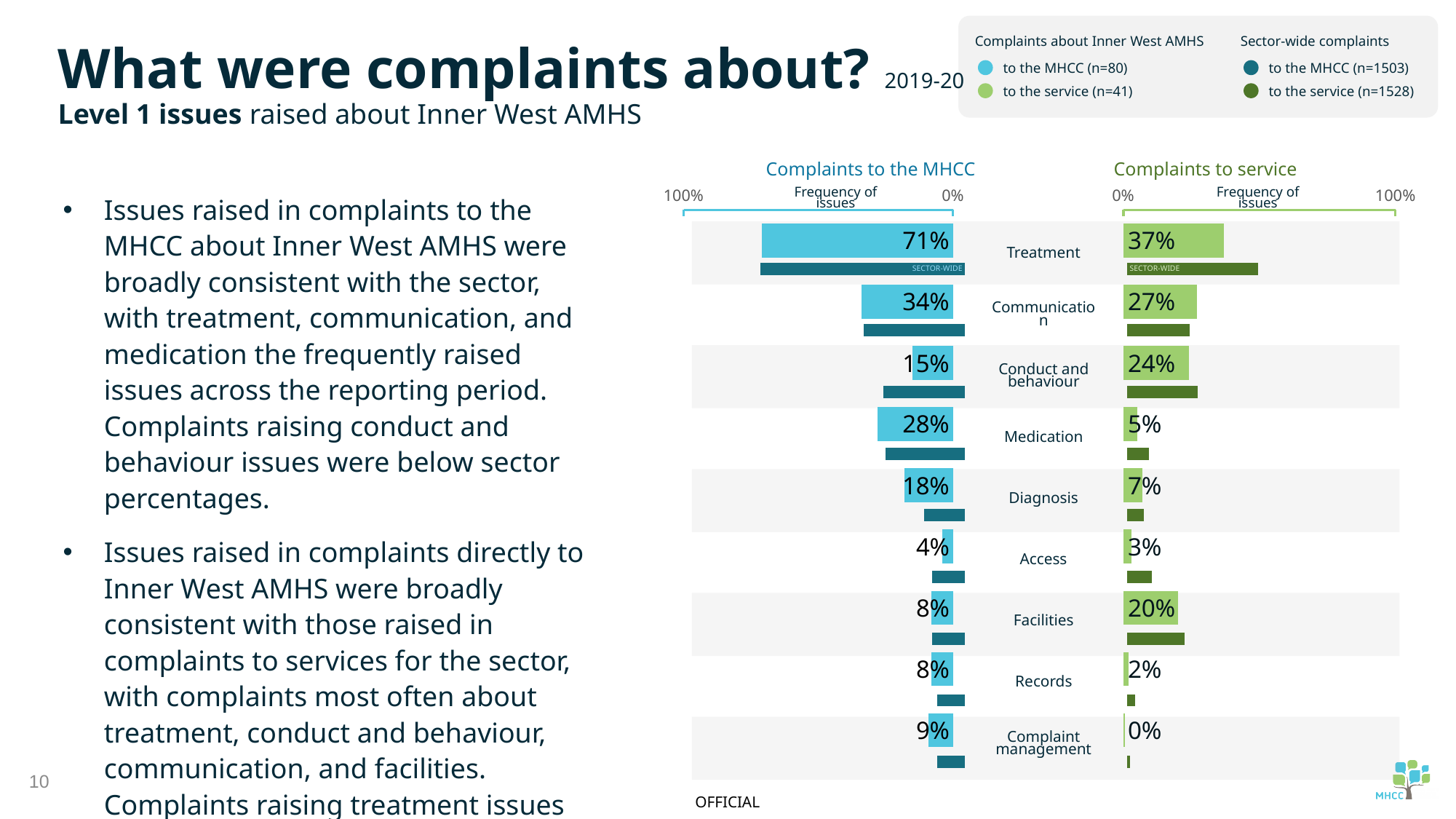
How many issue categories are shown in the Complaints to the MHCC chart? 9 In the Complaints to the MHCC chart, what is the value for Medication? 28% According to the legend, how many complaints about Inner West AMHS were made to the MHCC? n=80 Is the value for Conduct and behaviour higher in the Complaints to the MHCC chart or in the Complaints to service chart? Complaints to service In the Complaints to the MHCC chart, what is the value for Treatment? 71% In the Complaints to the MHCC chart, which issue has the highest value? Treatment In the Complaints to service chart, what is the value for Facilities? 20% In the Complaints to service chart, what is the difference between the values for Treatment and Communication? 10% In the Complaints to service chart, what is the value for Records? 2% In the Complaints to the MHCC chart, what is the difference between the values for Communication and Medication? 6% In the Complaints to service chart, which issue has the lowest value? Complaint management What type of chart is the Complaints to service chart? Bar chart